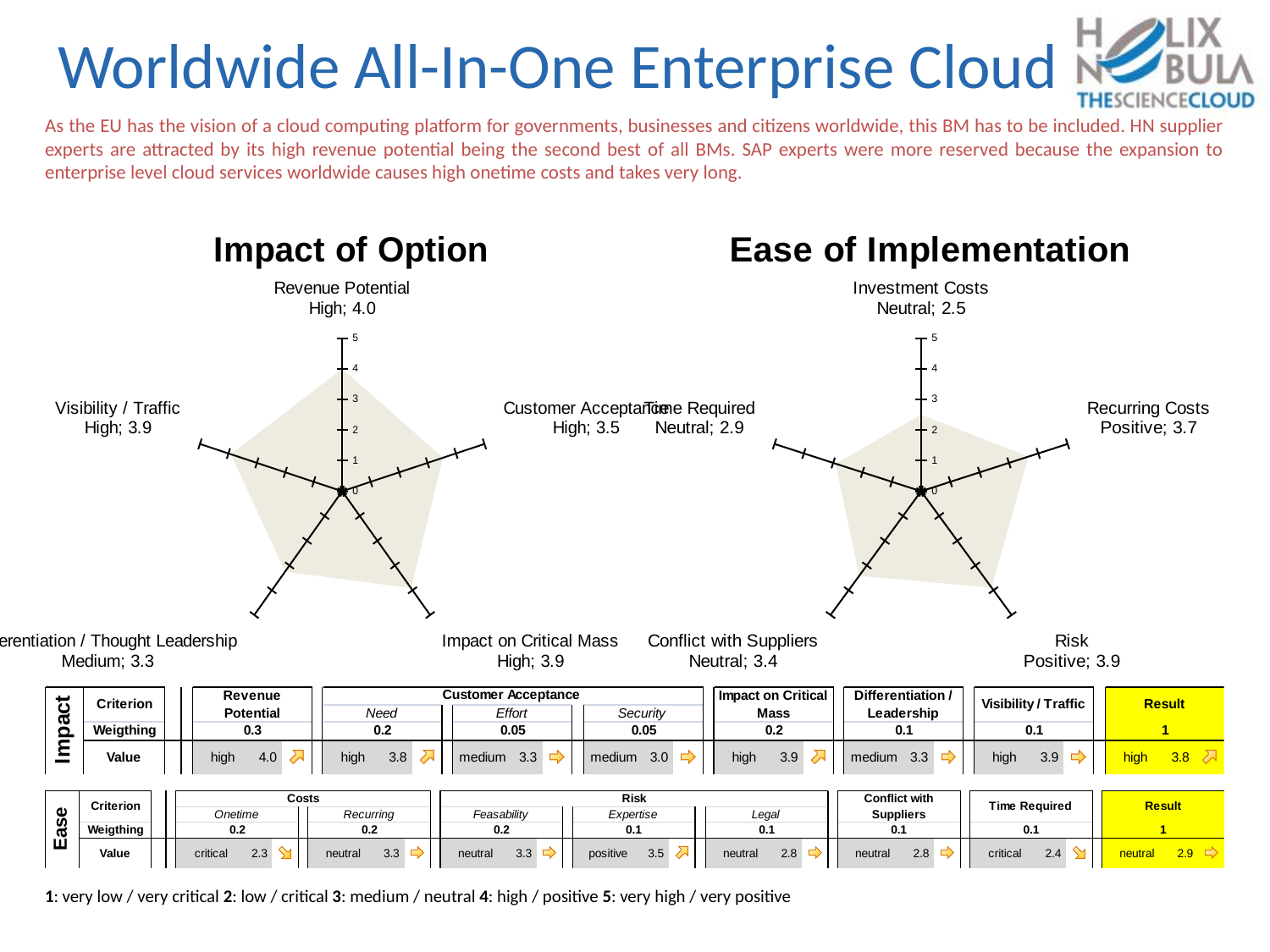
On the Ease of Implementation chart, which criterion has the lowest value? Investment Costs On the Impact of Option chart, which criterion has the highest value? Revenue Potential On the Ease of Implementation chart, what is the value for Time Required? 2.9 How many criteria (axes) does the Impact of Option chart have? 5 On the Ease of Implementation chart, what is the difference between the values for Risk and Investment Costs? 1.4 On the Ease of Implementation chart, which criterion has the highest value? Risk On the Impact of Option chart, what is the difference between the values for Revenue Potential and Customer Acceptance? 0.5 On the Impact of Option chart, what is the value for Customer Acceptance? 3.5 On the Ease of Implementation chart, what is the value for Investment Costs? 2.5 On the Ease of Implementation chart, which is larger: Recurring Costs or Conflict with Suppliers? Recurring Costs What kind of chart is the Ease of Implementation chart? Radar chart On the Impact of Option chart, what is the value for Revenue Potential? 4.0